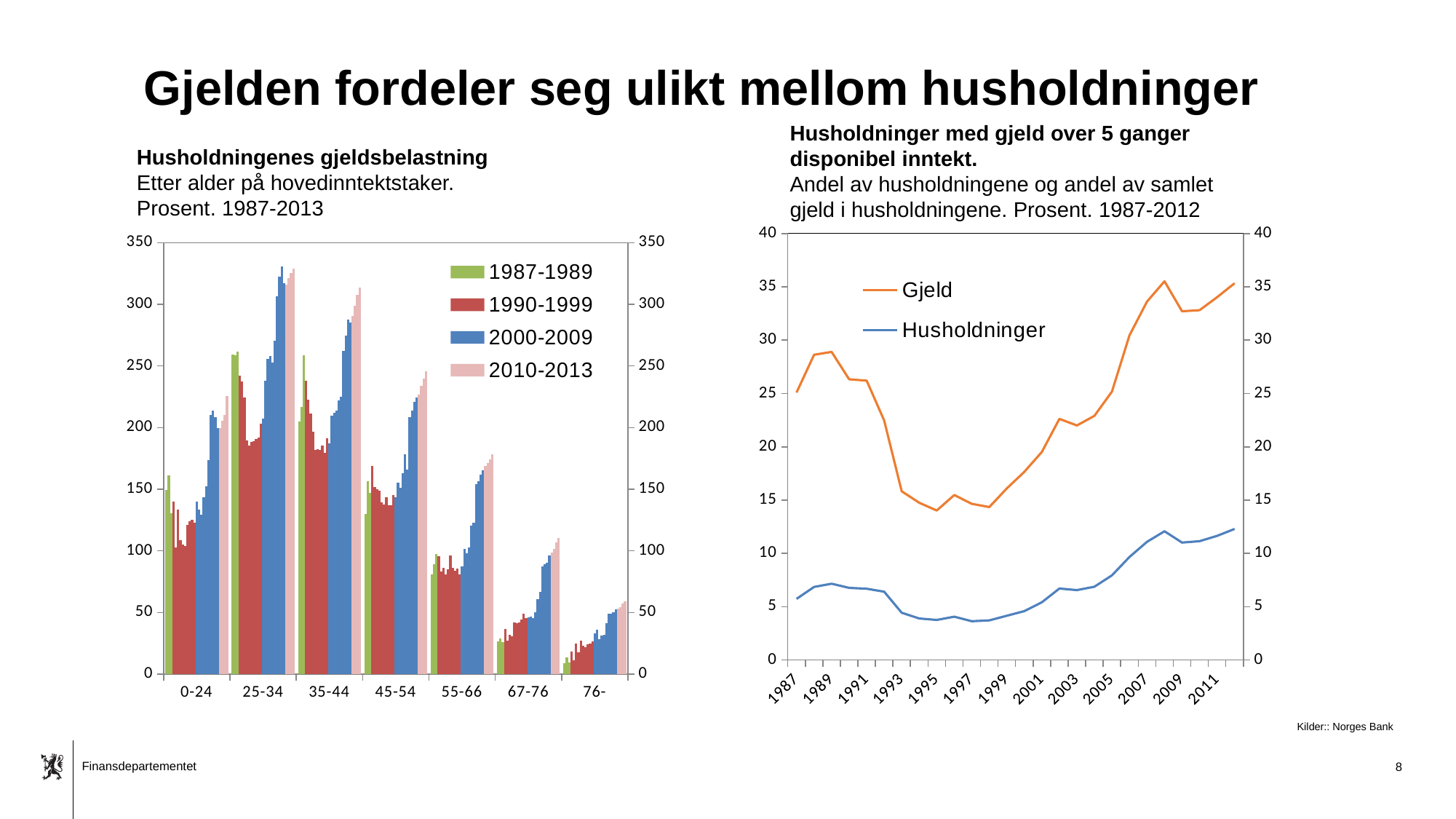
In the left chart, 'Husholdningenes gjeldsbelastning', which age group has the lowest bars? 76- How many series does the legend of the left chart, 'Husholdningenes gjeldsbelastning', list? 4 How many age groups are shown on the x axis of the left chart, 'Husholdningenes gjeldsbelastning'? 7 In the left chart, 'Husholdningenes gjeldsbelastning', which age group has the highest bars? 25-34 In the right chart, 'Husholdninger med gjeld over 5 ganger disponibel inntekt', is the Husholdninger value in 1997 greater or less than 5? less What kind of chart is the left chart, 'Husholdningenes gjeldsbelastning'? bar chart What kind of chart is the right chart, 'Husholdninger med gjeld over 5 ganger disponibel inntekt'? line chart In the left chart, 'Husholdningenes gjeldsbelastning', are the bars for the 67-76 age group greater or less than 150? less In the right chart, 'Husholdninger med gjeld over 5 ganger disponibel inntekt', is the Gjeld value in 2012 greater or less than 30? greater In the right chart, 'Husholdninger med gjeld over 5 ganger disponibel inntekt', does the Husholdninger series rise or fall from 2003 to 2008? rise In the right chart, 'Husholdninger med gjeld over 5 ganger disponibel inntekt', which series is higher in 2005, Gjeld or Husholdninger? Gjeld How many series does the legend of the right chart, 'Husholdninger med gjeld over 5 ganger disponibel inntekt', list? 2